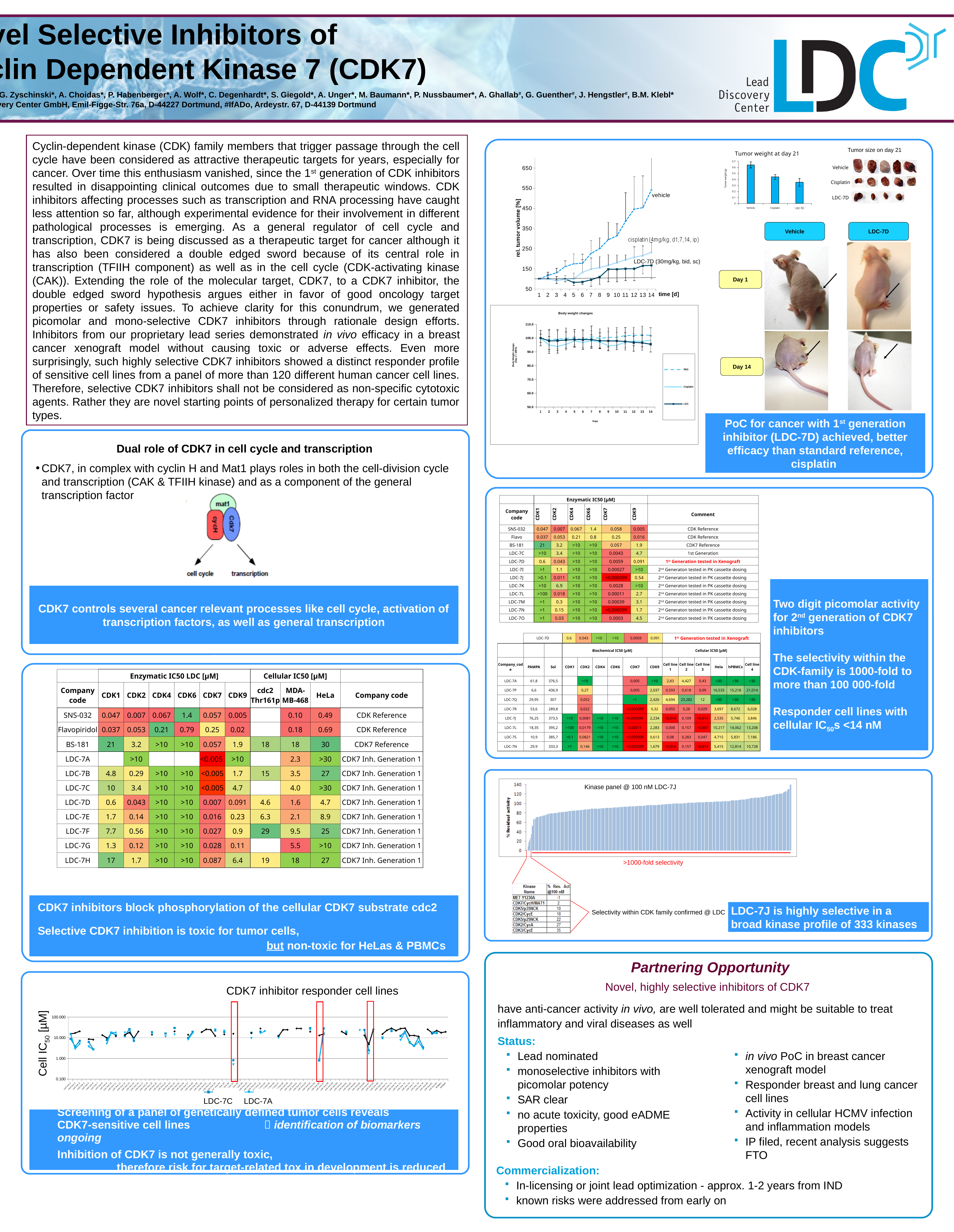
How many groups are shown in the 'Tumor weight at day 21' bar chart? 3 In the relative tumor volume chart, which treatment group has the highest tumor volume at day 14? vehicle In the relative tumor volume chart, which is larger at day 14: the cisplatin group or the LDC-7D group? cisplatin In the relative tumor volume chart, is the LDC-7D value at day 14 greater or less than 250? less In the relative tumor volume chart, is the vehicle value at day 14 greater or less than 450? greater In the 'Kinase panel @ 100 nM LDC-7J' chart, do the residual activity values rise or fall from left to right? rise How many series does the legend of the 'Body weight changes' chart list? 3 How many series does the legend of the 'CDK7 inhibitor responder cell lines' chart list? 2 What kind of chart is the 'Kinase panel @ 100 nM LDC-7J' chart? bar chart In the 'Tumor weight at day 21' bar chart, which group has the lowest tumor weight? LDC-7D In the 'Tumor weight at day 21' bar chart, which group has the highest tumor weight? Vehicle In the chart of relative tumor volume over time (top right), what kind of chart is it? line chart